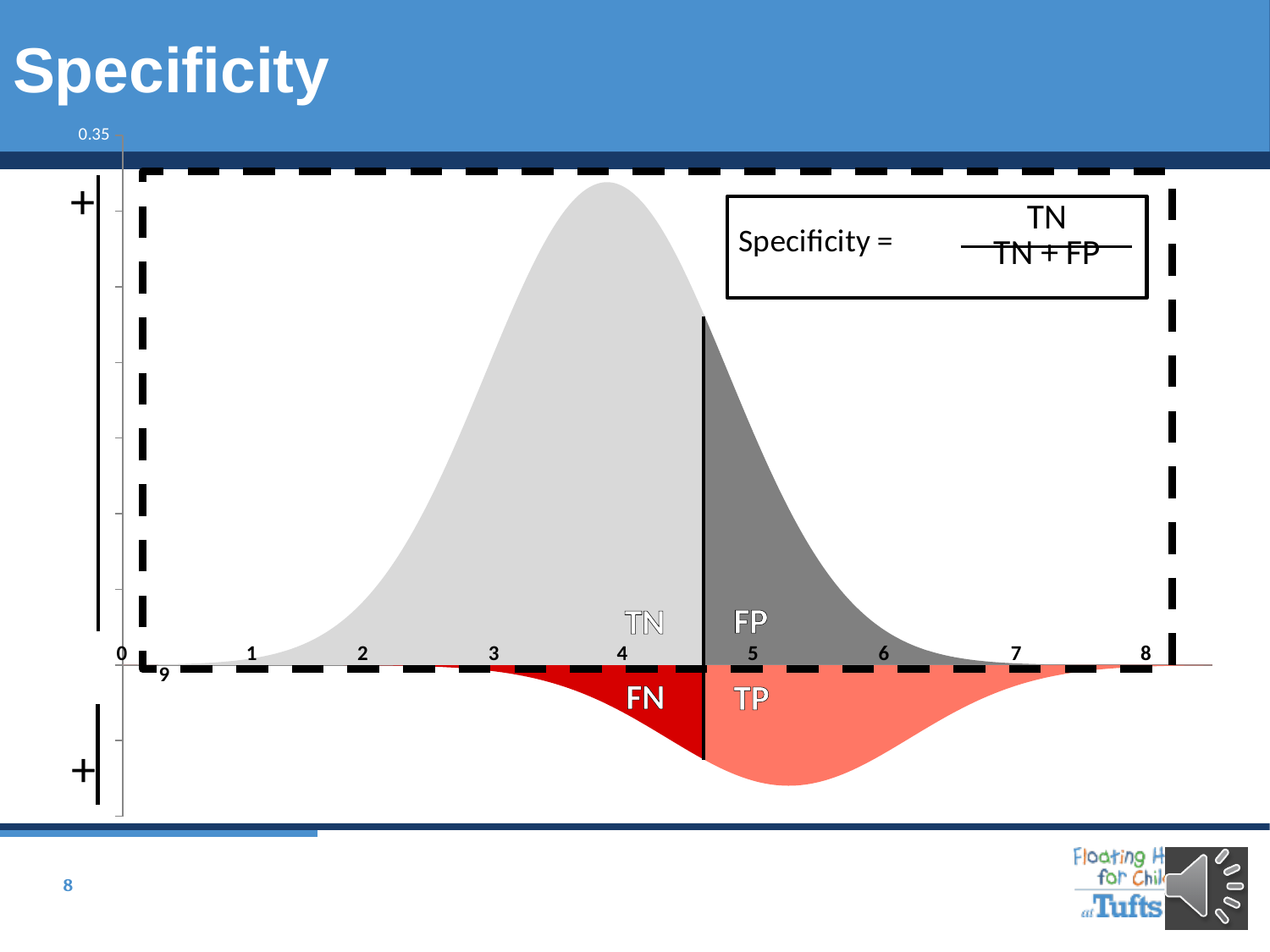
Does the upper grey curve rise or fall as x goes from 5 to 8? falls Which region is shaded dark grey? FP Is the peak of the lower red distribution at an x value greater or less than 5? greater Which shaded region above the x axis is larger in area, TN or FP? TN Which shaded region below the x axis is larger in area, TP or FN? TP According to the formula box, what is the denominator of Specificity? TN + FP Is the peak of the upper grey distribution at an x value greater or less than 5? less How many labeled regions (TN, FP, FN, TP) are shaded on the chart? 4 Does the upper grey curve rise or fall as x goes from 1 to 4? rises What kind of chart is shown on the slide? area chart Between which two x-axis tick labels does the vertical cutoff line fall? 4 and 5 Which region lies to the right of the vertical cutoff line above the x axis? FP